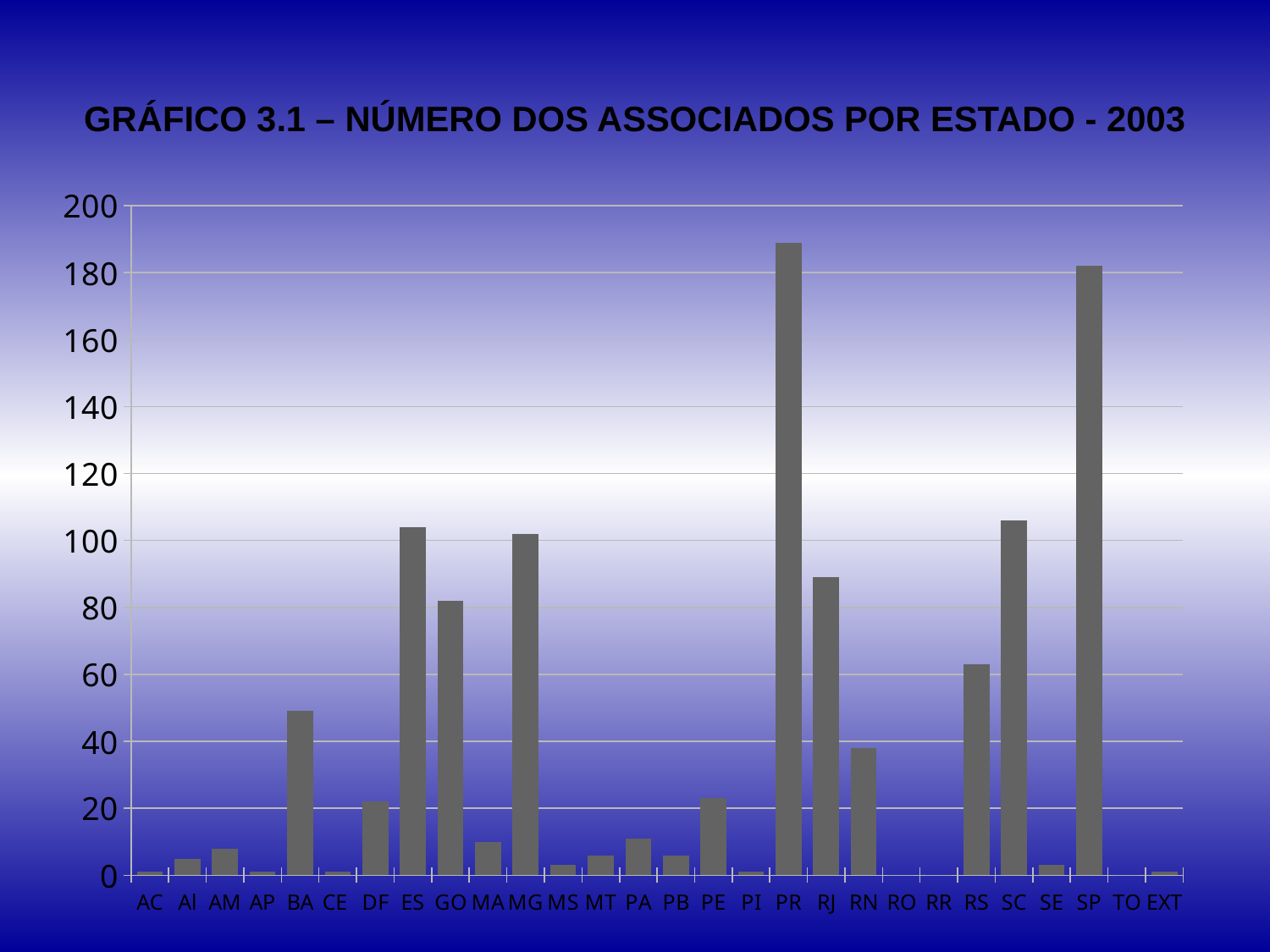
Which has more associates, SC or RJ? SC Is the value for BA greater or less than 60? less Is the value for MG greater or less than 80? greater Is the value for RN greater or less than 60? less Which has more associates, PR or SP? PR Which state has the highest number of associates? PR What kind of chart is shown on the slide? bar chart Which has more associates, BA or RS? RS What is the title of the chart? GRÁFICO 3.1 – NÚMERO DOS ASSOCIADOS POR ESTADO - 2003 How many categories (states) are shown on the x axis? 28